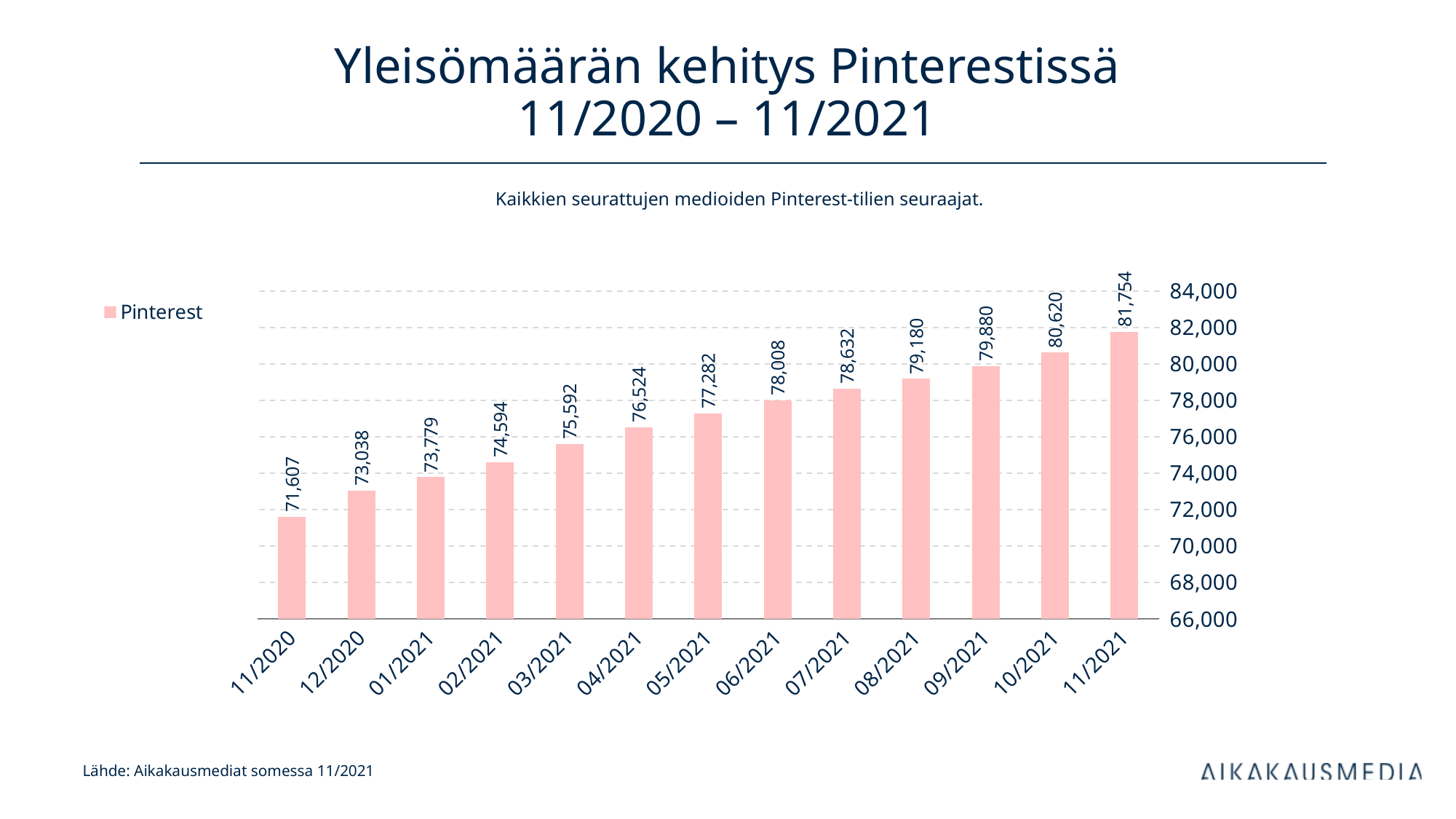
Which month has the highest value? 11/2021 What kind of chart is this? bar chart Which month has the lowest value? 11/2020 Is the value for 08/2021 greater or less than 78,000? greater Do the values rise or fall from 11/2020 to 11/2021? rise Which is larger, the value for 03/2021 or the value for 07/2021? 07/2021 How many months are shown on the x axis? 13 What is the value for 11/2020? 71,607 What is the difference between the values for 10/2021 and 09/2021? 740 What is the difference between the values for 11/2021 and 11/2020? 10,147 What is the value for 11/2021? 81,754 What is the value for 05/2021? 77,282